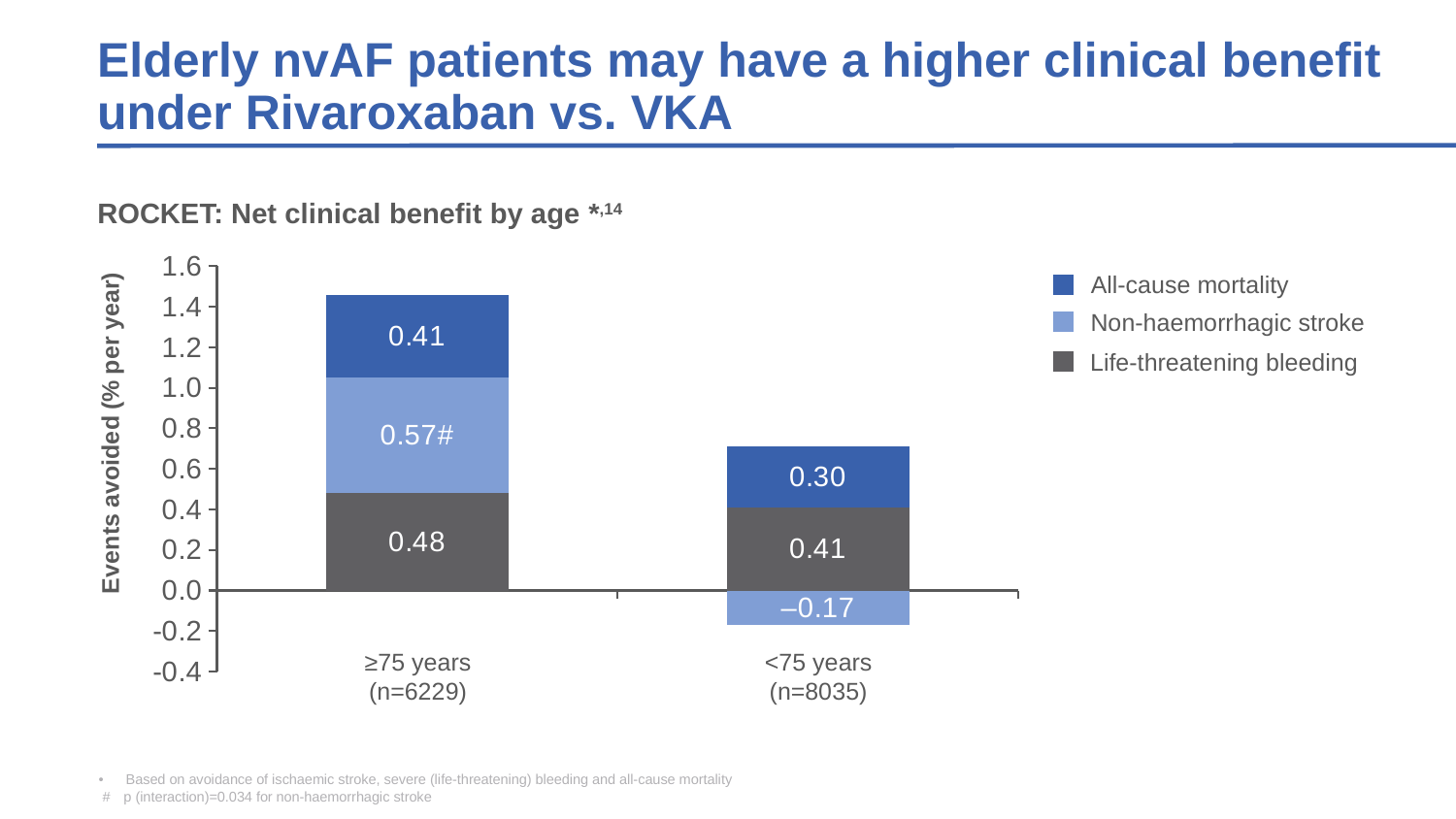
What is the value for All-cause mortality in the ≥75 years group? 0.41 How many series does the legend list? 3 What is the value for All-cause mortality in the <75 years group? 0.30 What type of chart is shown on the slide? Stacked bar chart What is the total of the stacked bar for the ≥75 years group? 1.46 How many age categories are shown on the x axis? 2 What is the value for Life-threatening bleeding in the <75 years group? 0.41 Which age group has the higher value for Life-threatening bleeding, ≥75 years or <75 years? ≥75 years What is the value for Non-haemorrhagic stroke in the ≥75 years group? 0.57 What is the value for Non-haemorrhagic stroke in the <75 years group? –0.17 What is the difference between the All-cause mortality values for the ≥75 years and <75 years groups? 0.11 What is the label of the y axis? Events avoided (% per year)